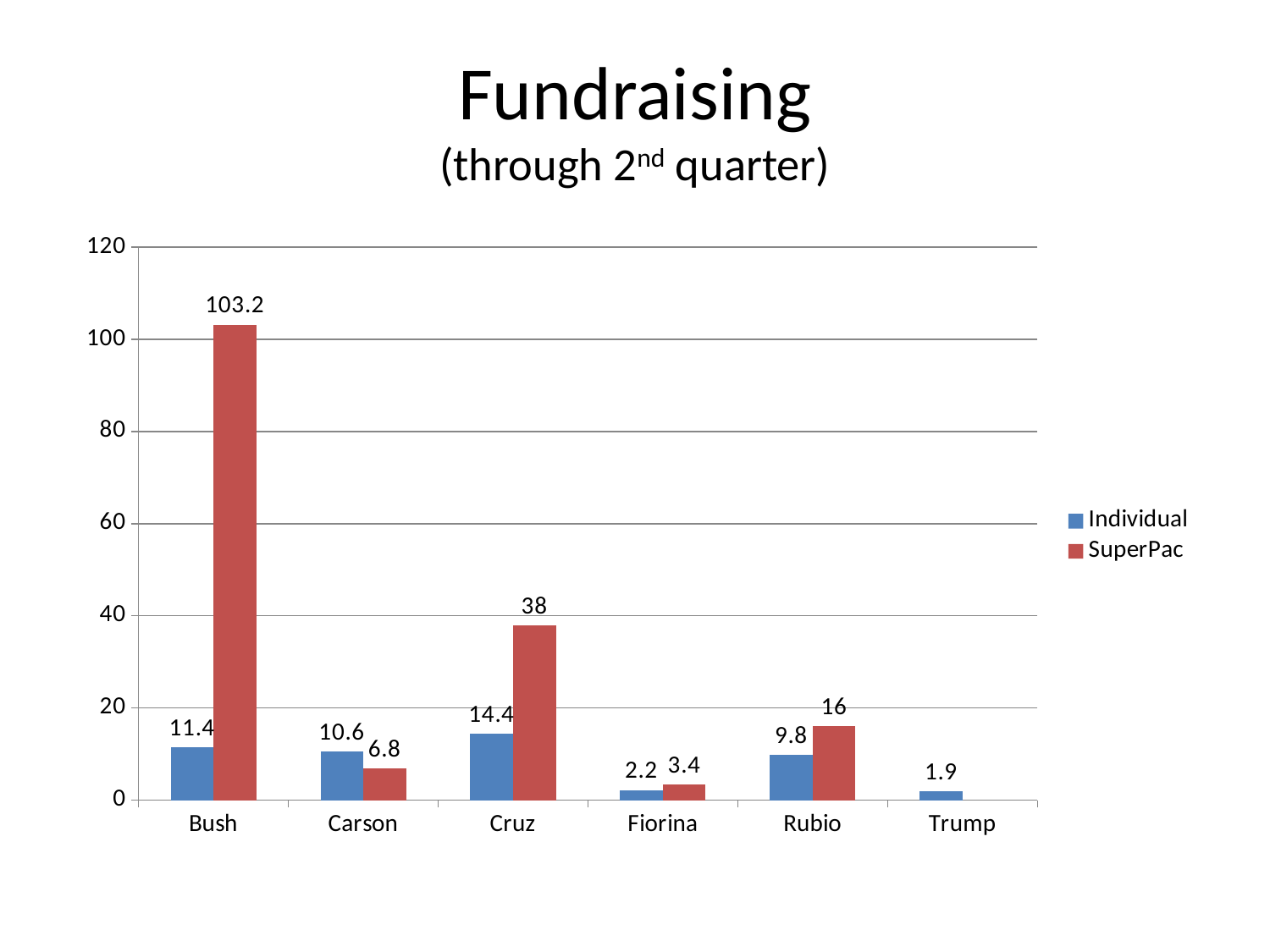
What is the Individual value for Trump? 1.9 How many series does the legend list? 2 Which candidate has the highest SuperPac value? Bush What is the title of the chart? Fundraising (through 2nd quarter) What is the SuperPac value for Bush? 103.2 How many candidates are shown on the x axis? 6 What is the Individual value for Cruz? 14.4 Which candidate has the lowest Individual value? Trump What is the difference between the SuperPac and Individual values for Cruz? 23.6 What kind of chart is shown on the slide? bar chart Which is larger for Carson, the Individual value or the SuperPac value? Individual Is the SuperPac value for Bush greater or less than 100? greater